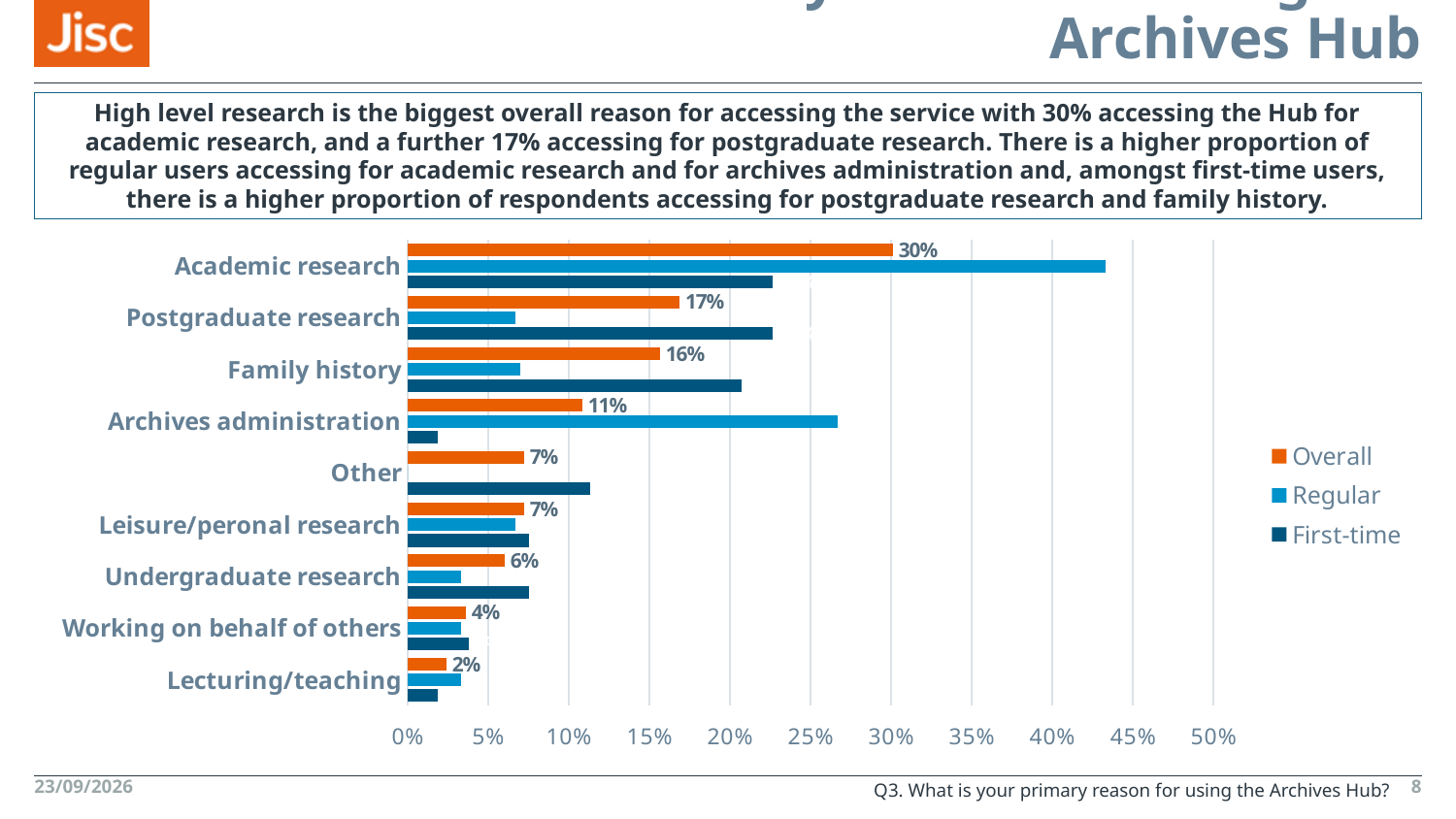
What is the difference between the Overall values for Academic research and Postgraduate research? 13 percentage points What is the Overall value for Postgraduate research? 17% Which category has the highest Overall value? Academic research What is the Overall value for Academic research? 30% Is the Regular value for Academic research greater or less than 40%? greater What is the Overall value for Archives administration? 11% How many categories are shown on the chart? 9 What is the Overall value for Lecturing/teaching? 2% For Academic research, which is larger: the Regular value or the First-time value? Regular For Postgraduate research, which is larger: the Regular value or the First-time value? First-time Which category has the lowest Overall value? Lecturing/teaching How many series does the legend list? 3